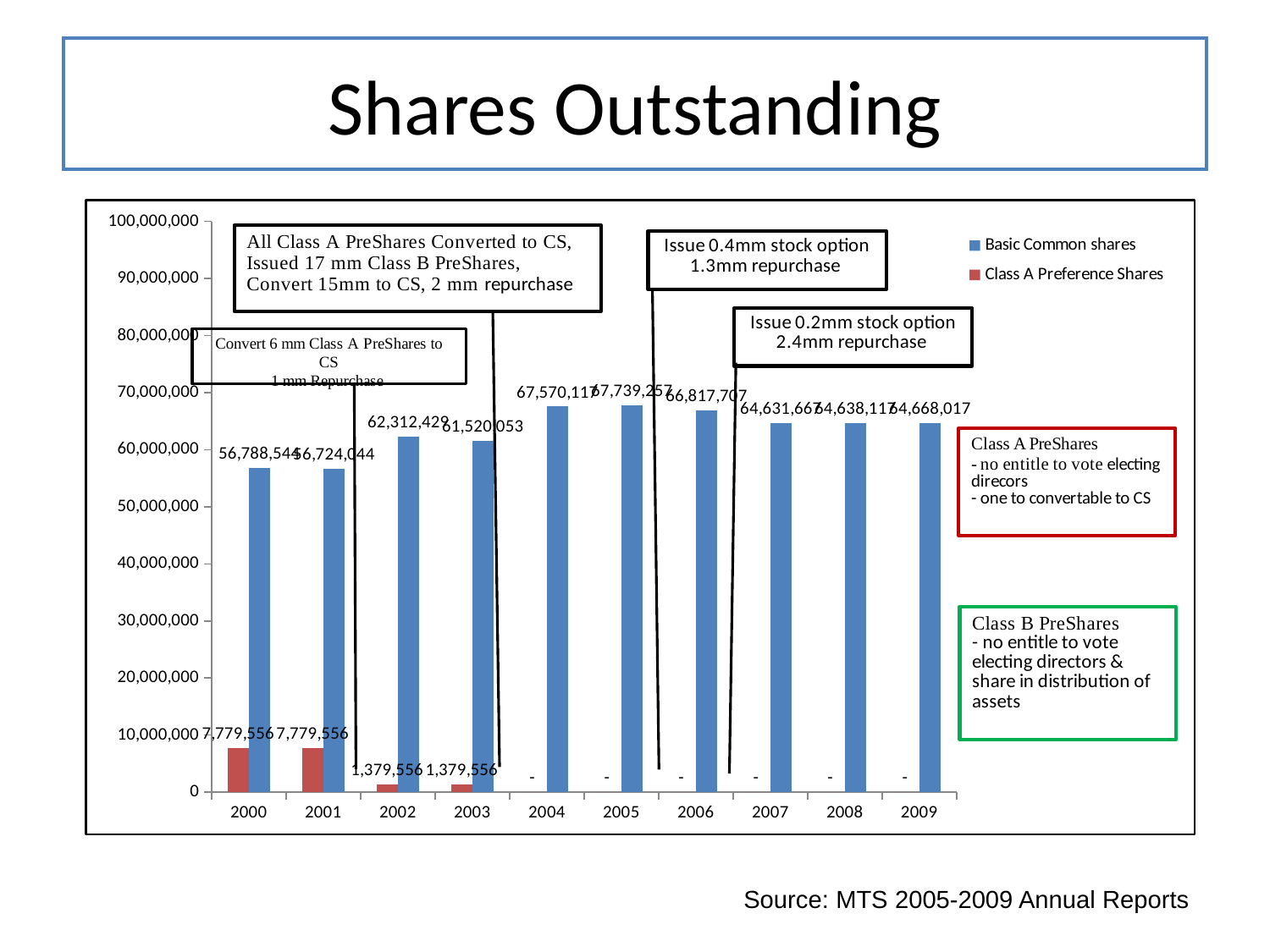
What is the value of Basic Common shares in 2003? 61,520,053 What is the difference between Class A Preference Shares in 2000 and in 2002? 6,400,000 What is the value of Class A Preference Shares in 2000? 7,779,556 Which year has more Basic Common shares, 2006 or 2009? 2006 What is the value of Basic Common shares in 2001? 56,724,044 How many years are shown on the x axis of the chart? 10 How many series does the legend list? 2 Is the value of Basic Common shares in 2003 greater or less than 60,000,000? greater What is the value of Basic Common shares in 2006? 66,817,707 What is the value of Class A Preference Shares in 2002? 1,379,556 What is the value of Basic Common shares in 2009? 64,668,017 Do the Class A Preference Shares rise or fall from 2000 to 2009? fall